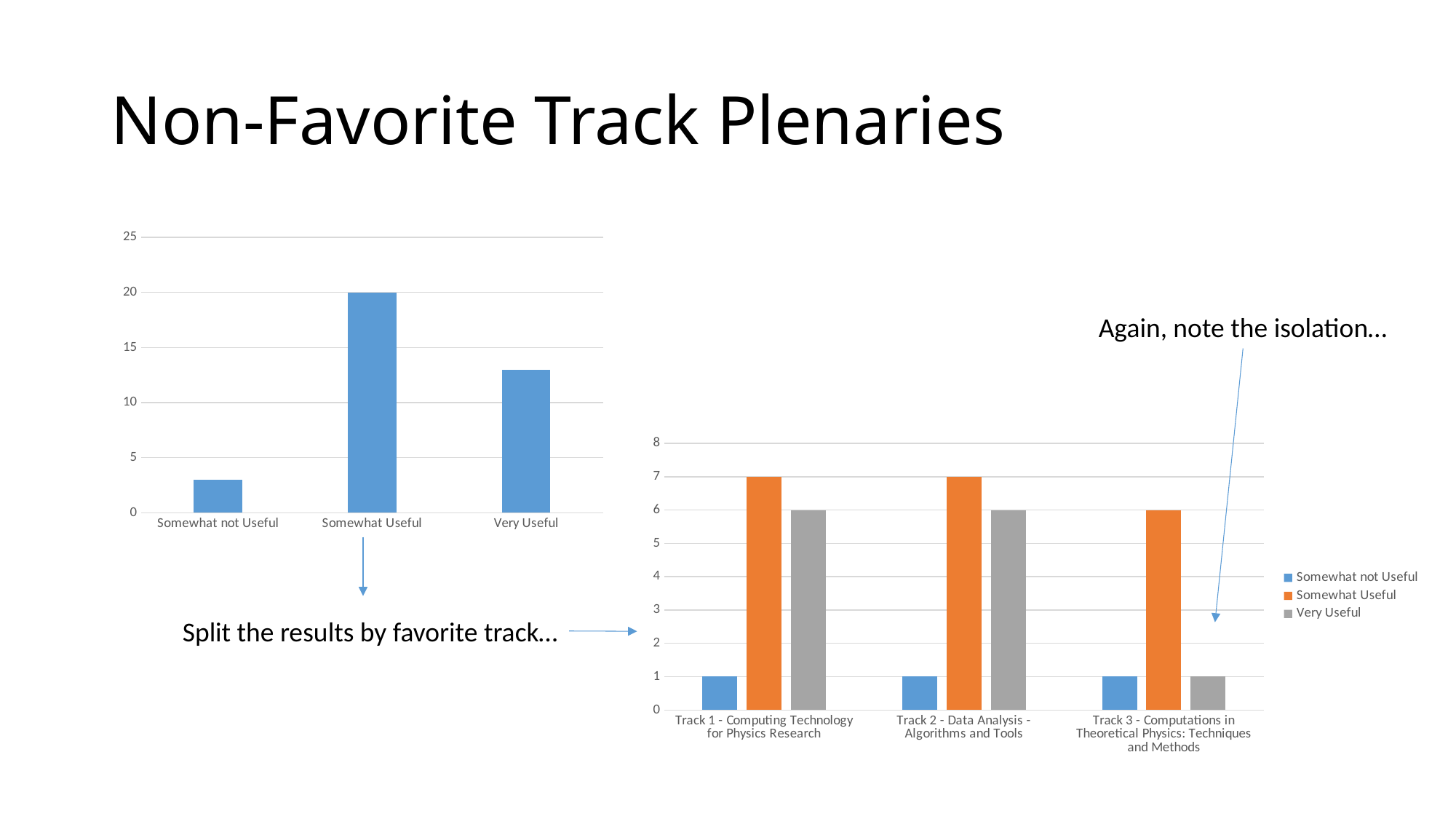
In the right chart, which is larger for Track 3: the Somewhat Useful value or the Very Useful value? Somewhat Useful In the right chart, what is the Very Useful value for Track 3 - Computations in Theoretical Physics: Techniques and Methods? 1 In the left chart, what is the value for Somewhat Useful? 20 In the right chart, what is the difference between the Somewhat Useful and Very Useful values for Track 2 - Data Analysis - Algorithms and Tools? 1 In the left chart, which category has the highest value? Somewhat Useful In the left chart, which category has the lowest value? Somewhat not Useful In the right chart, what is the Somewhat Useful value for Track 1 - Computing Technology for Physics Research? 7 In the left chart, how many categories are shown on the x axis? 3 In the left chart, is the value for Somewhat not Useful greater or less than 5? less In the left chart, is the value for Very Useful greater or less than 10? greater What type of chart is the right chart? Bar chart In the right chart, how many series does the legend list? 3